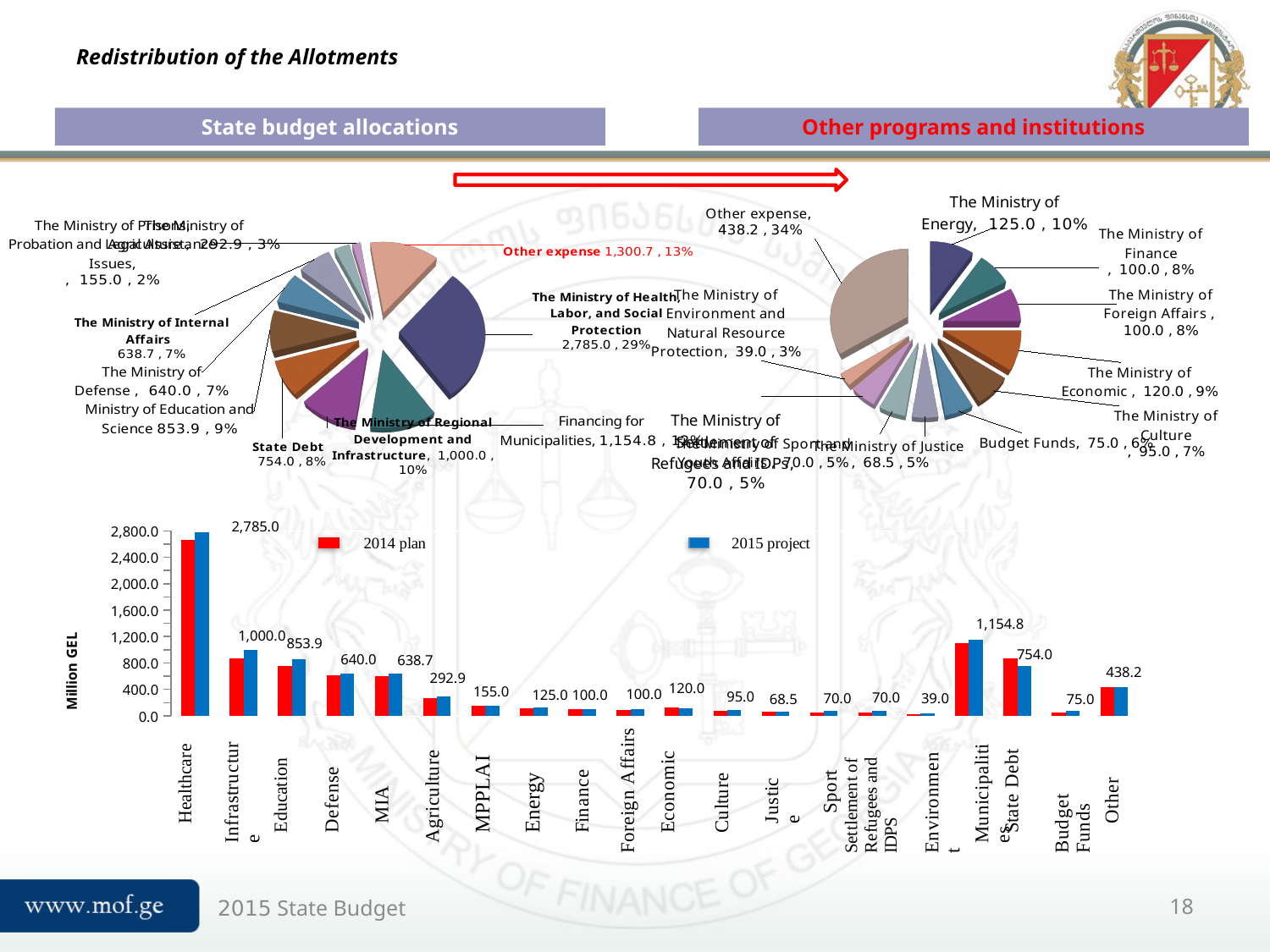
In the 'Other programs and institutions' pie chart, what is the difference between the values for The Ministry of Energy and The Ministry of Economic? 5.0 How many series does the legend of the bottom bar chart list? 2 In the 'State budget allocations' pie chart, which is larger: Ministry of Education and Science or The Ministry of Defense? Ministry of Education and Science In the bottom bar chart, is the 2014 plan value for Municipalities greater or less than 800.0? greater How many categories are shown on the x axis of the bottom bar chart? 20 In the 'Other programs and institutions' pie chart, what share does Other expense have? 34% What kind of chart is the chart at the bottom of the slide? bar chart What are the two series named in the legend of the bottom bar chart? 2014 plan and 2015 project In the 'Other programs and institutions' pie chart, what is the value for The Ministry of Energy? 125.0 In the bottom bar chart, which category has the highest bars? Healthcare In the bottom bar chart, what value is labelled for Healthcare? 2,785.0 In the 'State budget allocations' pie chart, what share does The Ministry of Health, Labor, and Social Protection have? 29%